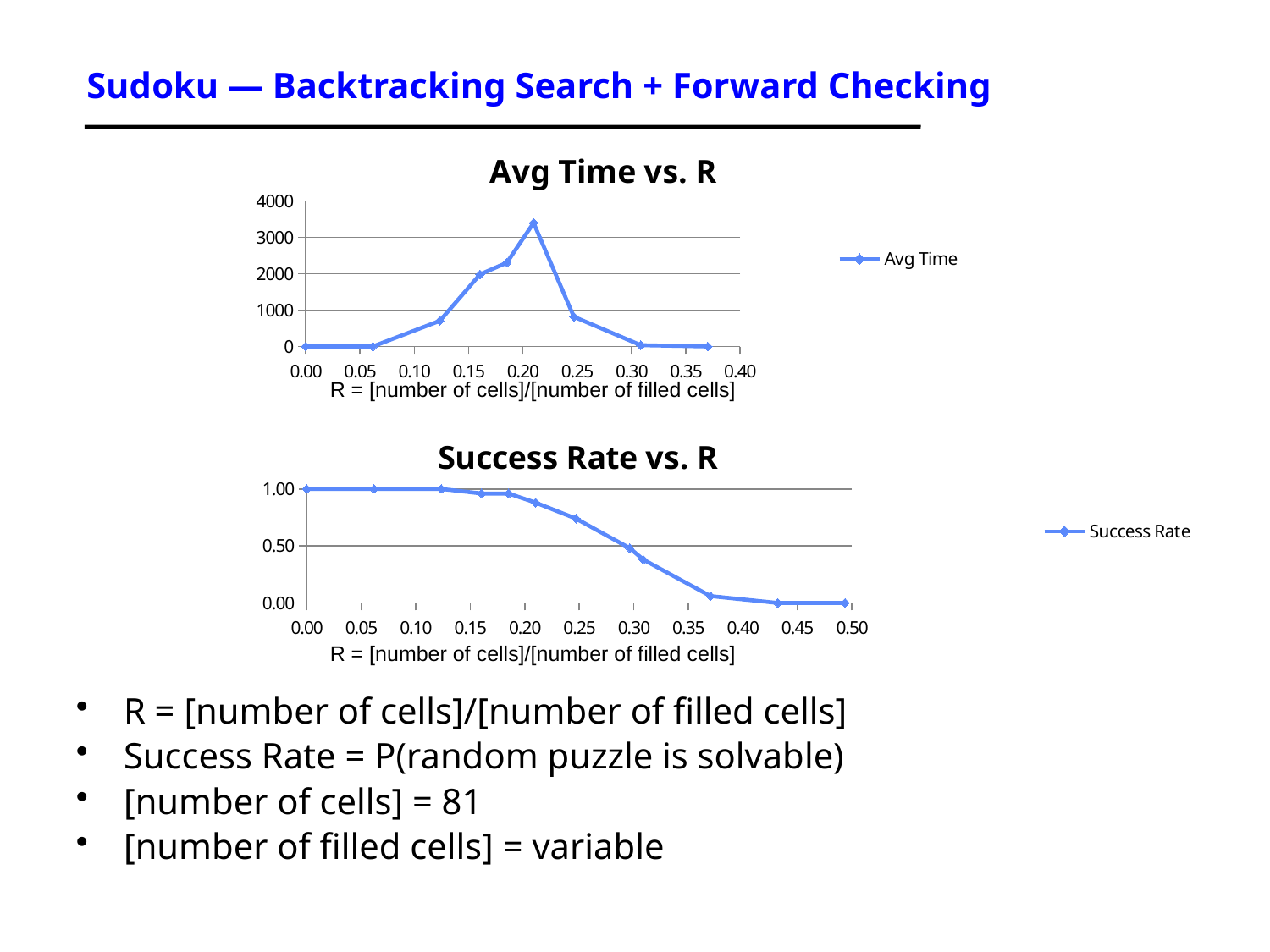
What is the legend entry of the "Avg Time vs. R" chart? Avg Time In the "Success Rate vs. R" chart, which is larger: the value at R = 0.00 or the value at R = 0.40? R = 0.00 How many series does the legend of the "Success Rate vs. R" chart list? 1 In the "Success Rate vs. R" chart, is the value at R = 0.00 greater or less than 0.50? greater What is the x-axis title of the "Success Rate vs. R" chart? R = [number of cells]/[number of filled cells] What kind of chart is the "Success Rate vs. R" chart? line chart In the "Avg Time vs. R" chart, is the value at R = 0.00 greater or less than 1000? less In the "Success Rate vs. R" chart, is the value at R = 0.50 greater or less than 0.50? less How many series does the legend of the "Avg Time vs. R" chart list? 1 What kind of chart is the "Avg Time vs. R" chart? line chart In the "Success Rate vs. R" chart, do the values generally rise or fall as R increases? fall